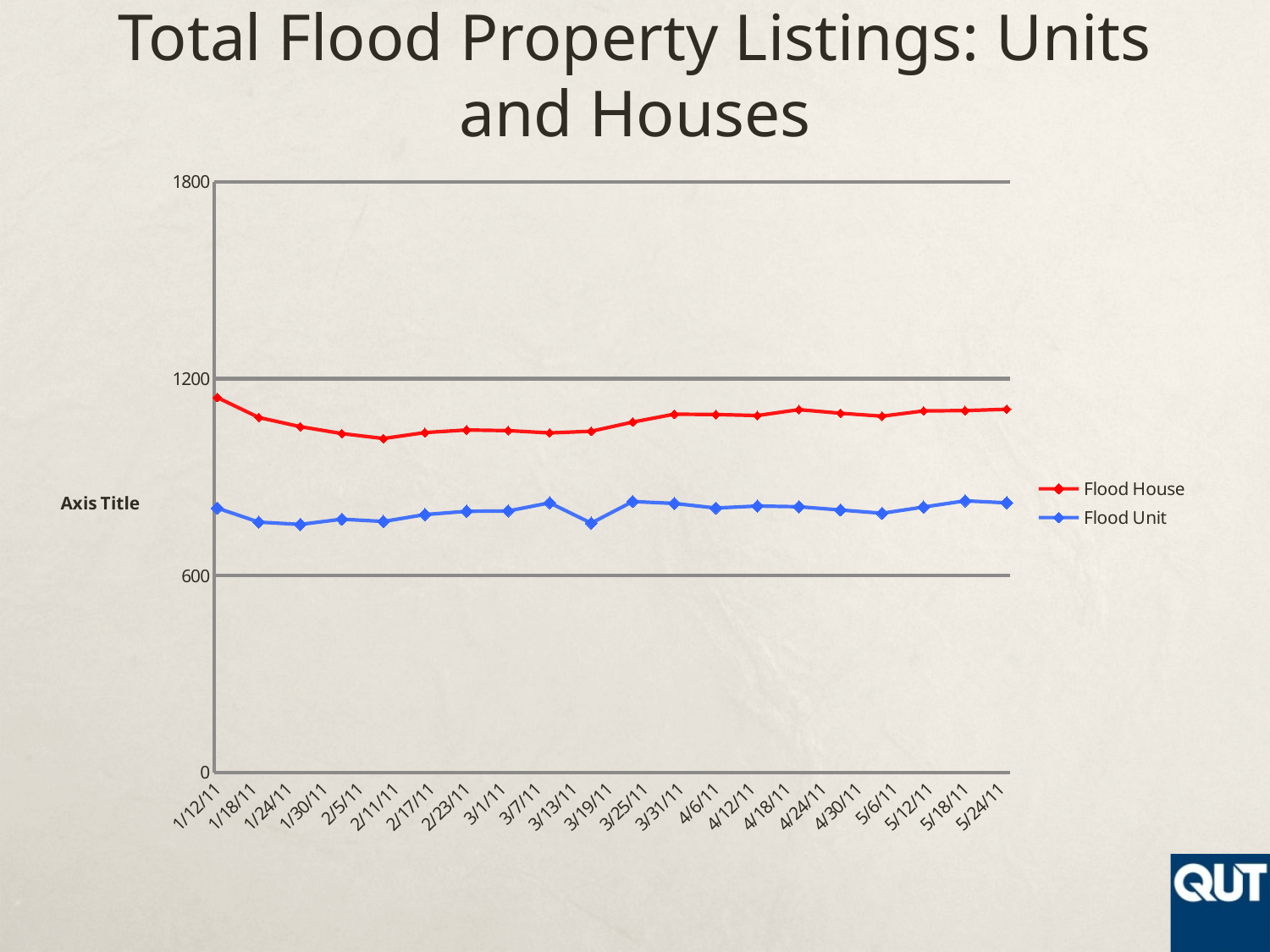
Does the Flood House series rise or fall between 1/12/11 and 2/11/11? fall What are the names of the two series in the legend? Flood House and Flood Unit How many series does the legend list? 2 On which date does the Flood House series reach its highest value? 1/12/11 Is the value for Flood Unit on 1/12/11 greater or less than 600? greater What is the title of the chart? Total Flood Property Listings: Units and Houses Which series has the larger value on 3/1/11, Flood House or Flood Unit? Flood House Is the value for Flood Unit on 3/25/11 greater or less than 1200? less Is the value for Flood House on 1/12/11 greater or less than 1200? less What kind of chart is shown on the slide? line chart How many dates are shown along the x axis? 23